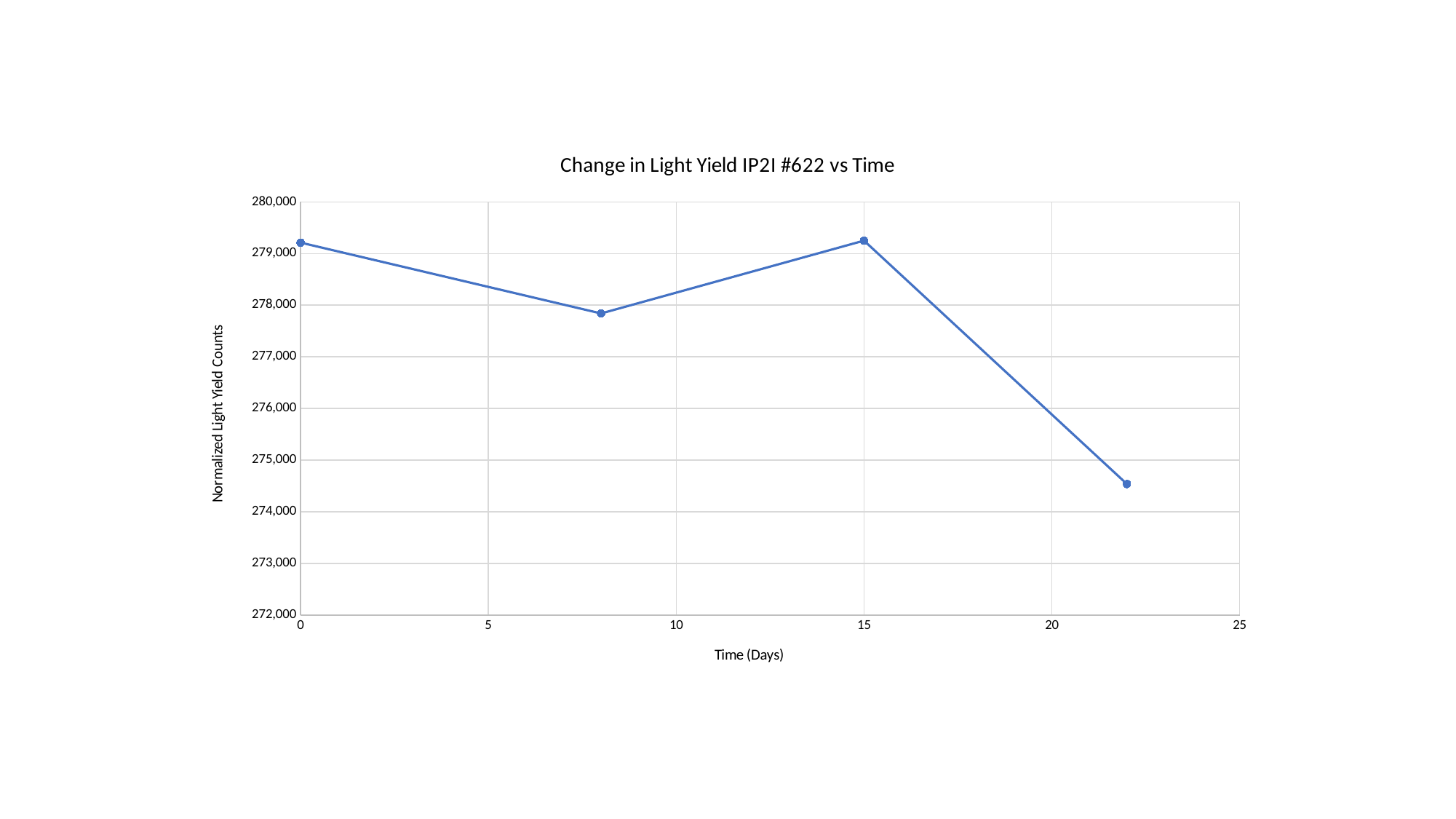
How many data points are plotted on the line? 4 Which has the higher normalized light yield, day 8 or day 22? day 8 Is the value at day 22 greater or less than 275,000? less Does the normalized light yield rise or fall between day 15 and day 22? fall Is the value at day 0 greater or less than 279,000? greater What is the label of the y axis? Normalized Light Yield Counts Is the value at day 15 greater or less than 279,000? greater What is the title of the chart? Change in Light Yield IP2I #622 vs Time What kind of chart is shown on the slide? line chart Overall, is the normalized light yield at the last point higher or lower than at the first point? lower At which time (in days) is the normalized light yield lowest? 22